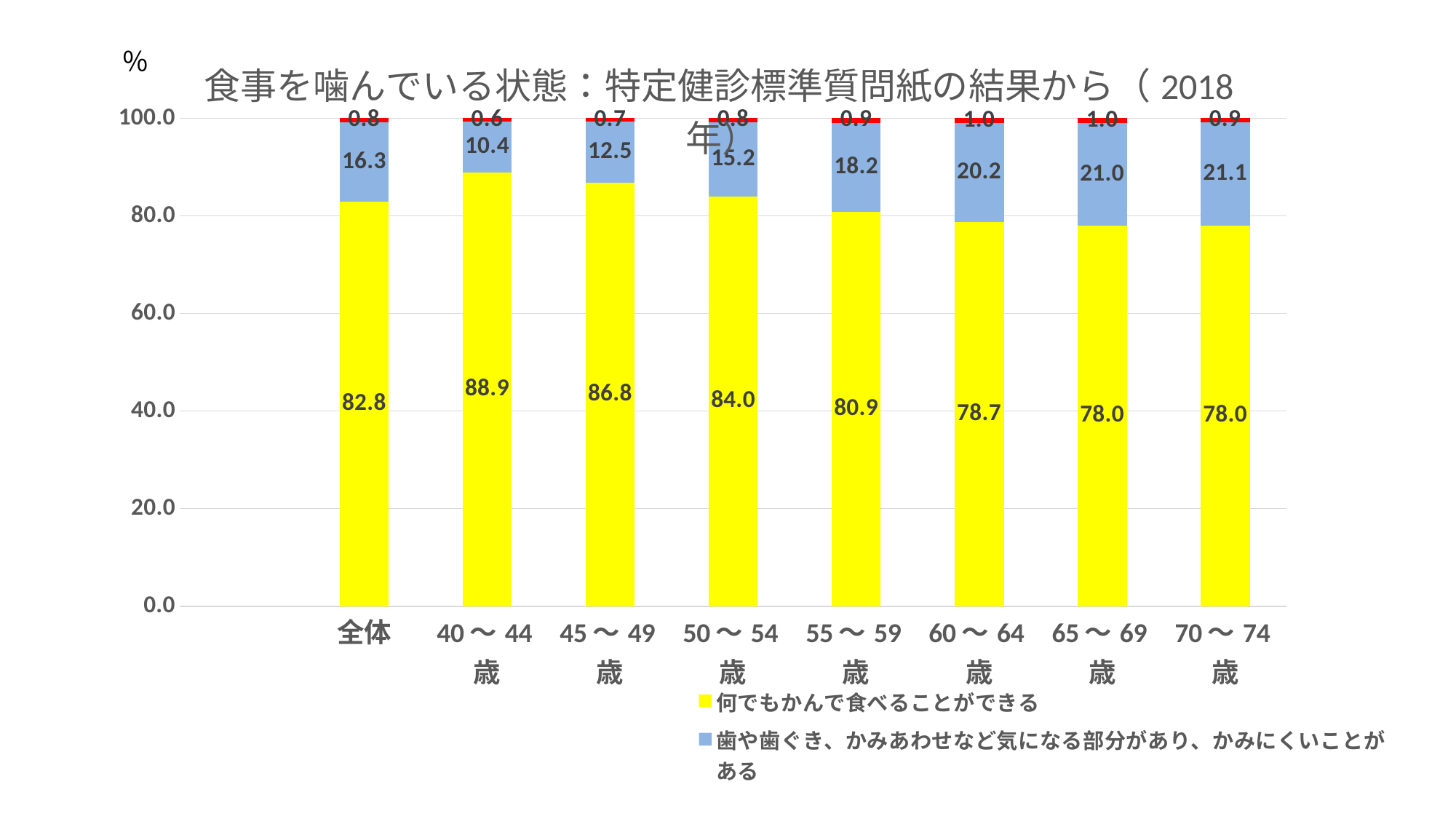
Does the value of 何でもかんで食べることができる rise or fall from 40〜44歳 to 70〜74歳? Fall What kind of chart is shown on the slide? Stacked bar chart What colour represents 何でもかんで食べることができる in the chart? Yellow What is the value of 何でもかんで食べることができる for 全体? 82.8 What is the value of 何でもかんで食べることができる for the 40〜44歳 group? 88.9 How many series does the legend list? 2 Which is larger: the 歯や歯ぐき、かみあわせなど気になる部分があり、かみにくいことがある value for 55〜59歳 or for 50〜54歳? 55〜59歳 How many categories are shown on the x axis? 8 What is the difference between the 何でもかんで食べることができる values for 40〜44歳 and 70〜74歳? 10.9 What is the value of 歯や歯ぐき、かみあわせなど気になる部分があり、かみにくいことがある for the 70〜74歳 group? 21.1 Which category has the lowest value for 歯や歯ぐき、かみあわせなど気になる部分があり、かみにくいことがある? 40〜44歳 Which age group has the highest value for 何でもかんで食べることができる? 40〜44歳